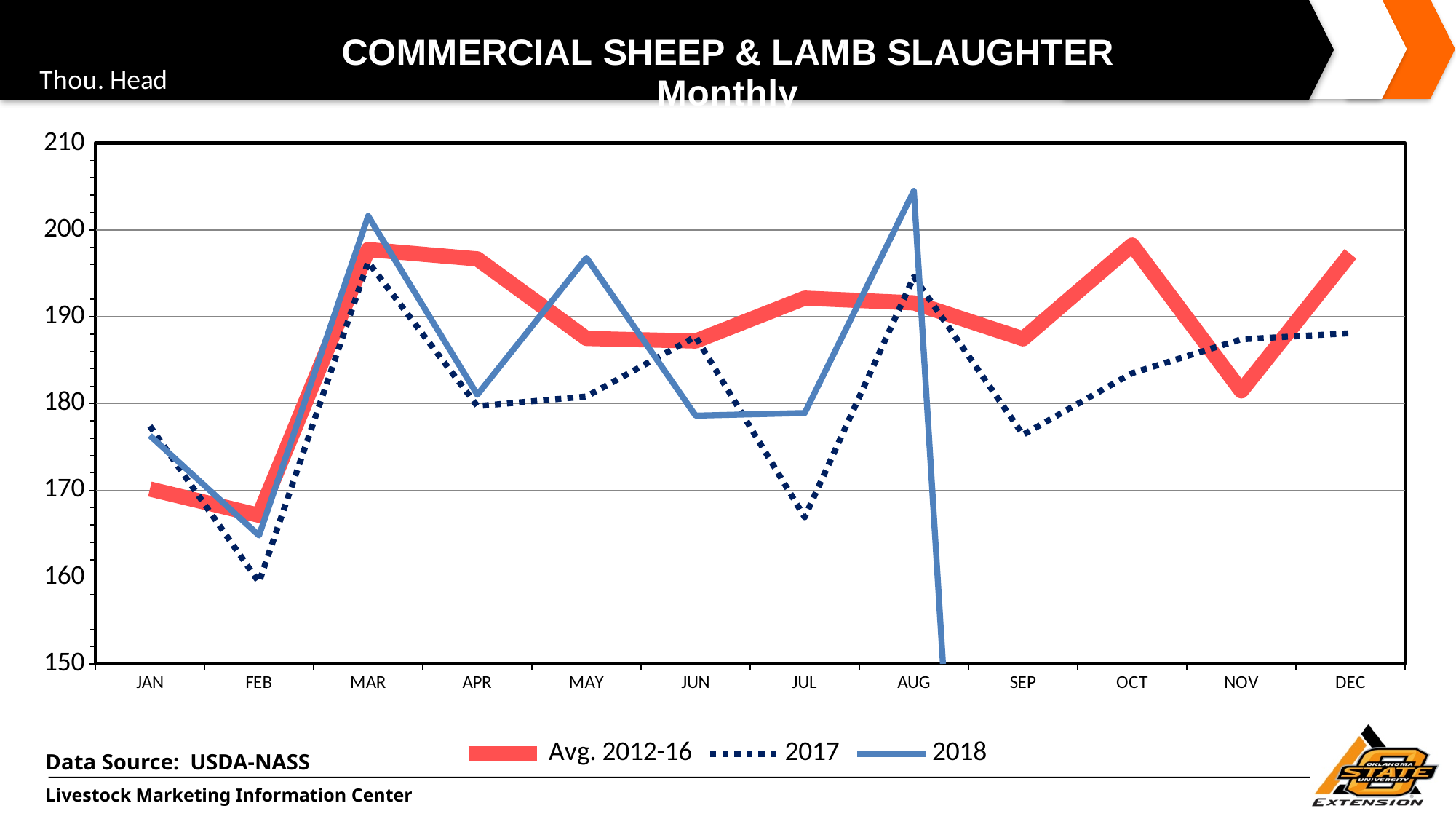
Is the 2018 value for AUG greater or less than 200? greater How many series does the legend list? 3 Does the Avg. 2012-16 series rise or fall from FEB to MAR? rise In which month is the 2018 series at its highest? AUG Is the 2017 value for FEB greater or less than 170? less In JUL, which series is larger: 2017 or 2018? 2018 What kind of chart is shown on the slide? line chart Is the Avg. 2012-16 value for NOV greater or less than 190? less How many months are shown along the x axis? 12 What unit is shown in the top-left corner of the slide for the y axis? Thou. Head In which month is the 2017 series at its lowest? FEB